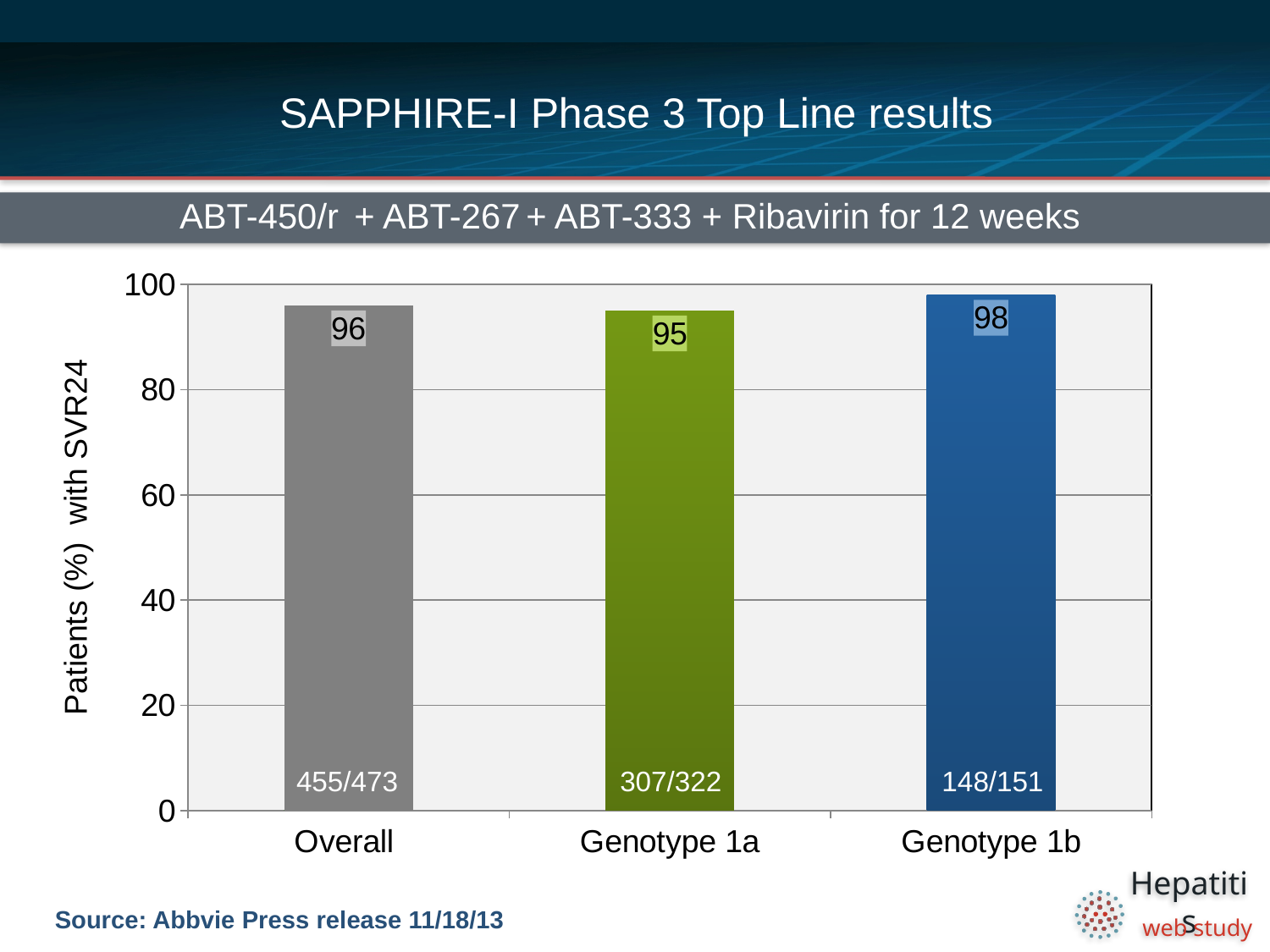
Which category has the highest SVR24 rate? Genotype 1b Which category has the lowest SVR24 rate? Genotype 1a Which has a higher SVR24 rate, Overall or Genotype 1b? Genotype 1b What kind of chart is shown on the slide? Bar chart What is the difference in SVR24 rate between Genotype 1b and Genotype 1a? 3 What fraction of patients achieved SVR24 in the Genotype 1b group, as labelled on the bar? 148/151 How many categories are shown on the x axis? 3 What is the SVR24 rate (%) for the Overall group? 96 What is the SVR24 rate (%) for Genotype 1b? 98 What is the label of the y axis? Patients (%) with SVR24 What is the SVR24 rate (%) for Genotype 1a? 95 What fraction of patients achieved SVR24 in the Overall group, as labelled on the bar? 455/473